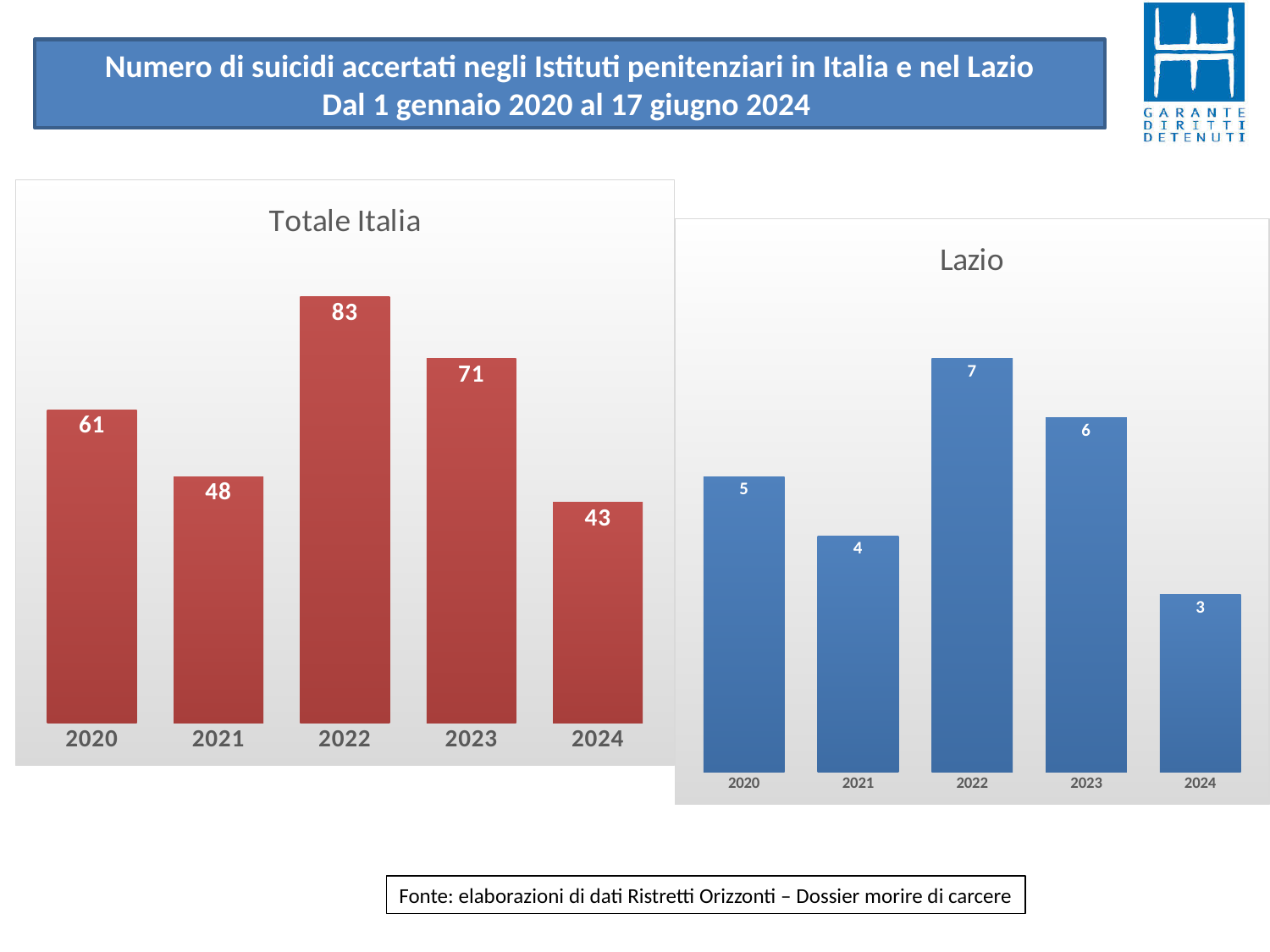
What colour are the bars in the 'Lazio' chart? Blue In the 'Lazio' chart, which year has the larger value, 2021 or 2023? 2023 In the 'Totale Italia' chart, which year has the highest value? 2022 In the 'Totale Italia' chart, which year has the larger value, 2020 or 2023? 2023 In the 'Lazio' chart, what is the value for 2021? 4 How many years are shown in the 'Totale Italia' chart? 5 In the 'Totale Italia' chart, what is the value for 2022? 83 In the 'Totale Italia' chart, what is the difference between the values for 2022 and 2024? 40 In the 'Lazio' chart, which year has the lowest value? 2024 In the 'Lazio' chart, what is the difference between the values for 2022 and 2020? 2 In the 'Totale Italia' chart, do the values rise or fall from 2022 to 2024? Fall What kind of chart is the 'Lazio' chart? Bar chart